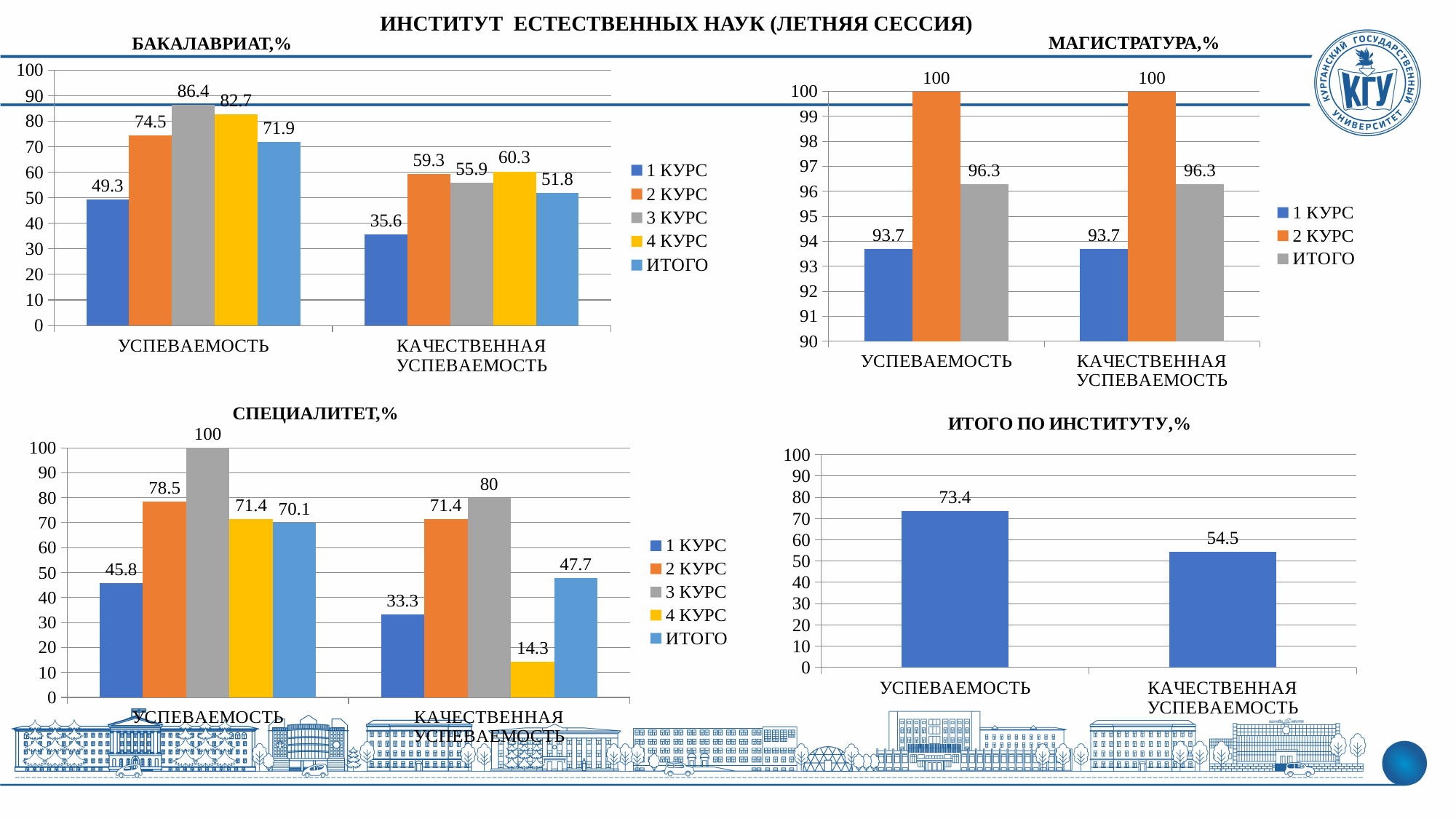
In the СПЕЦИАЛИТЕТ,% chart, which is larger under УСПЕВАЕМОСТЬ: 2 КУРС or ИТОГО? 2 КУРС In the БАКАЛАВРИАТ,% chart, which series has the lowest value under КАЧЕСТВЕННАЯ УСПЕВАЕМОСТЬ? 1 КУРС In the СПЕЦИАЛИТЕТ,% chart, what is the difference between the 3 КУРС and 1 КУРС values under КАЧЕСТВЕННАЯ УСПЕВАЕМОСТЬ? 46.7 In the МАГИСТРАТУРА,% chart, what is the value for ИТОГО under УСПЕВАЕМОСТЬ? 96.3 What kind of chart is the ИТОГО ПО ИНСТИТУТУ,% chart? bar chart How many series does the legend of the БАКАЛАВРИАТ,% chart list? 5 In the МАГИСТРАТУРА,% chart, which series has the highest value under КАЧЕСТВЕННАЯ УСПЕВАЕМОСТЬ? 2 КУРС How many categories are shown on the x axis of the ИТОГО ПО ИНСТИТУТУ,% chart? 2 In the СПЕЦИАЛИТЕТ,% chart, what is the value for 4 КУРС under КАЧЕСТВЕННАЯ УСПЕВАЕМОСТЬ? 14.3 In the БАКАЛАВРИАТ,% chart, what is the difference between the 4 КУРС and 1 КУРС values under УСПЕВАЕМОСТЬ? 33.4 In the ИТОГО ПО ИНСТИТУТУ,% chart, what is the value for КАЧЕСТВЕННАЯ УСПЕВАЕМОСТЬ? 54.5 In the БАКАЛАВРИАТ,% chart, what is the value for 3 КУРС under УСПЕВАЕМОСТЬ? 86.4